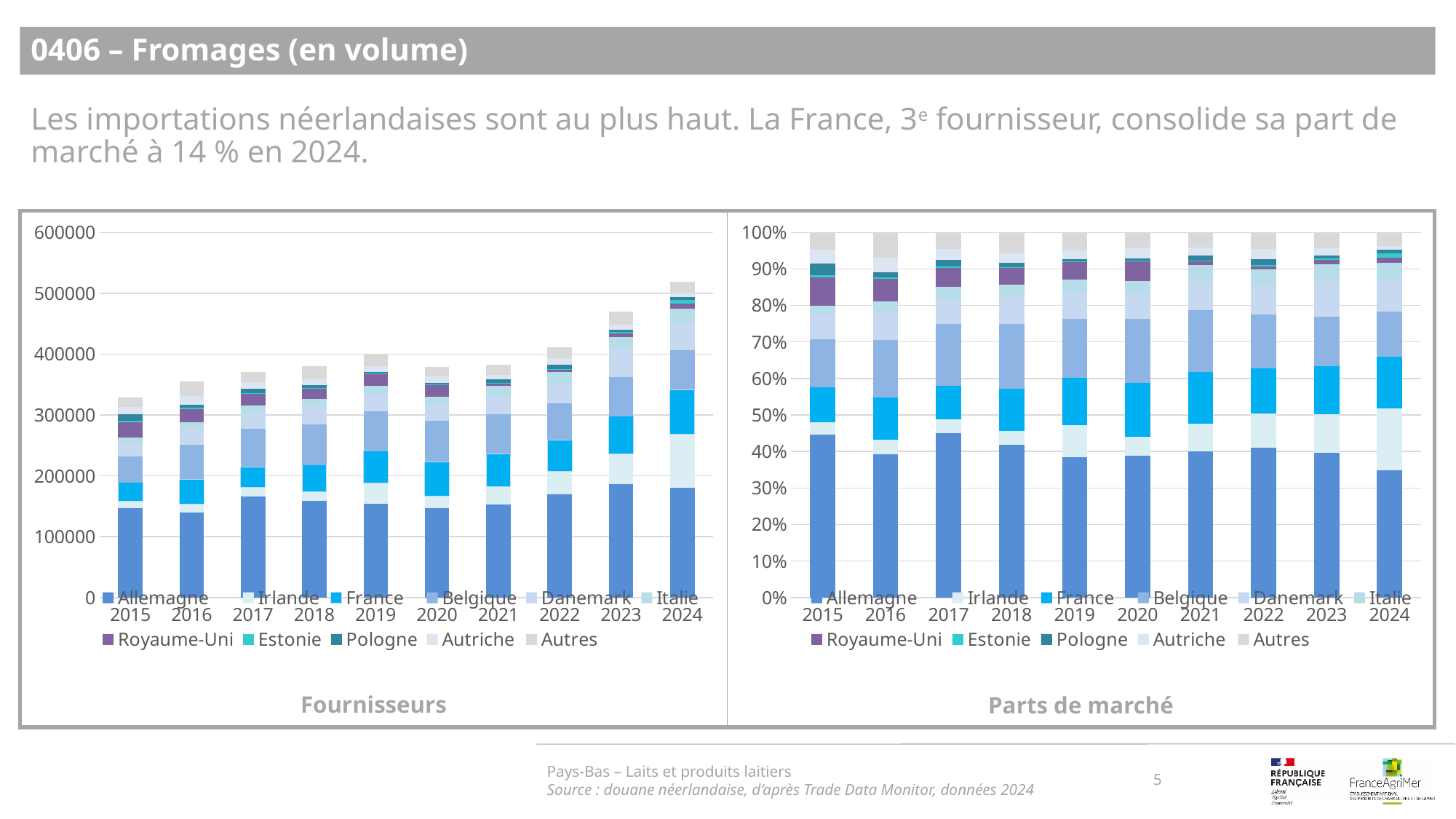
What kind of chart is the Fournisseurs chart on the left? Stacked bar chart In the Parts de marché chart, is the share of Allemagne in 2024 greater or less than 40%? less In the Parts de marché chart, is the share of Allemagne in 2017 greater or less than 40%? greater In the Fournisseurs chart, which year has the lowest total bar? 2015 In the Fournisseurs chart, which year has the highest total bar? 2024 What is the title of the chart on the right of the slide? Parts de marché In the Fournisseurs chart, do the total bars rise or fall from 2021 to 2024? rise In the Fournisseurs chart, is the total bar for 2015 greater or less than 400000? less How many series does the legend of the Fournisseurs chart list? 11 In the Parts de marché chart, is the share of Allemagne larger in 2017 or in 2024? 2017 How many years are shown on the x axis of the Parts de marché chart? 10